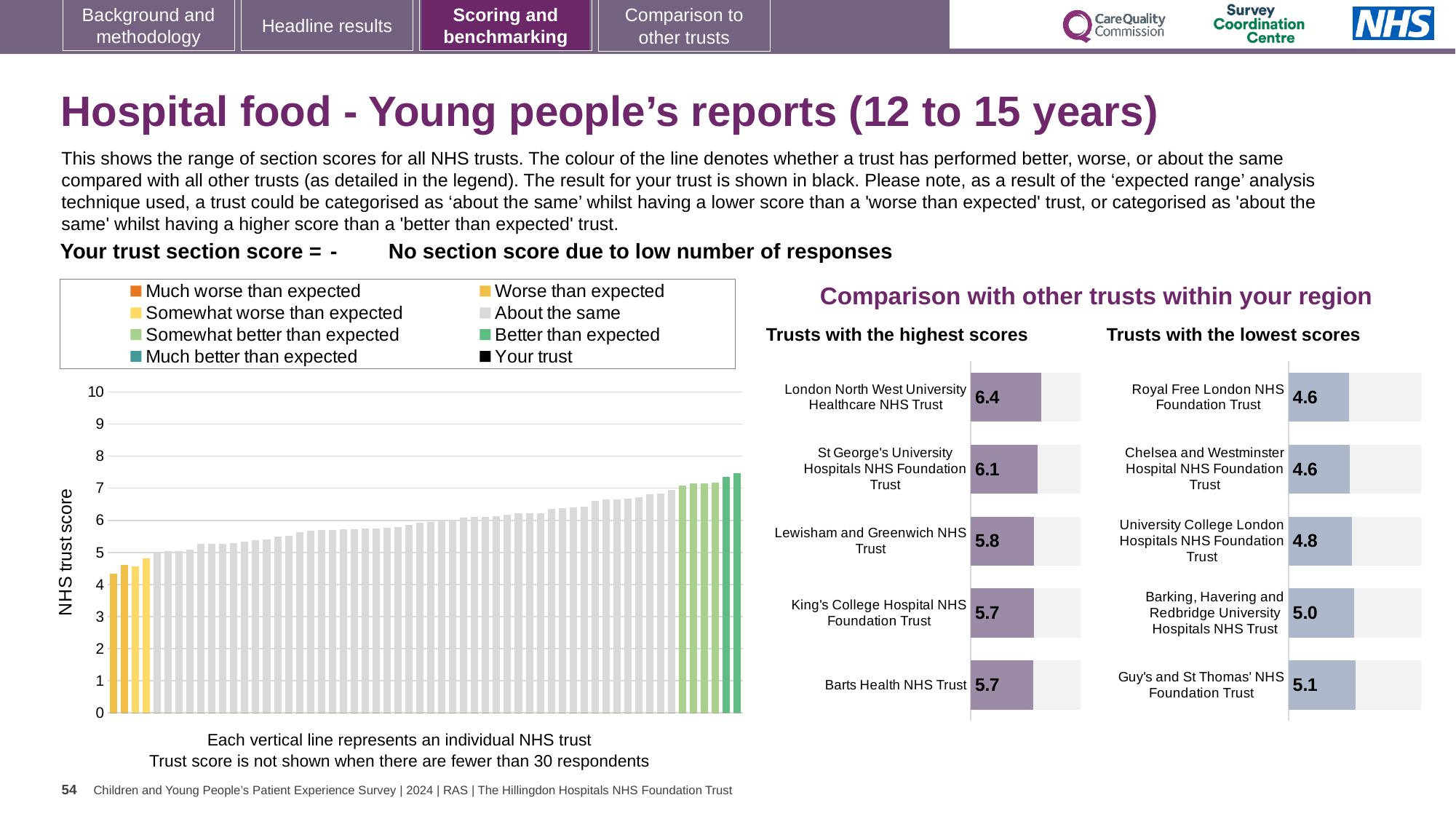
In the 'Trusts with the lowest scores' chart, what is the score for Guy's and St Thomas' NHS Foundation Trust? 5.1 In the 'Trusts with the lowest scores' chart, what is the score for University College London Hospitals NHS Foundation Trust? 4.8 What kind of chart is the large 'NHS trust score' chart on the left of the slide? bar chart In the 'Trusts with the highest scores' chart, which trust has the highest score? London North West University Healthcare NHS Trust In the 'Trusts with the highest scores' chart, what is the score for London North West University Healthcare NHS Trust? 6.4 In the 'Trusts with the lowest scores' chart, how many trusts are listed? 5 In the 'Trusts with the highest scores' chart, what is the score for Barts Health NHS Trust? 5.7 In the 'NHS trust score' chart on the left, do the bar values rise or fall from left to right? rise In the 'NHS trust score' chart on the left, is the value of the rightmost bar greater or less than 7? greater In the 'Trusts with the lowest scores' chart, which has the larger score: Barking, Havering and Redbridge University Hospitals NHS Trust or Royal Free London NHS Foundation Trust? Barking, Havering and Redbridge University Hospitals NHS Trust In the 'Trusts with the lowest scores' chart, what is the difference between the scores of Guy's and St Thomas' NHS Foundation Trust and Royal Free London NHS Foundation Trust? 0.5 In the 'Trusts with the highest scores' chart, what is the difference between the scores of London North West University Healthcare NHS Trust and Lewisham and Greenwich NHS Trust? 0.6